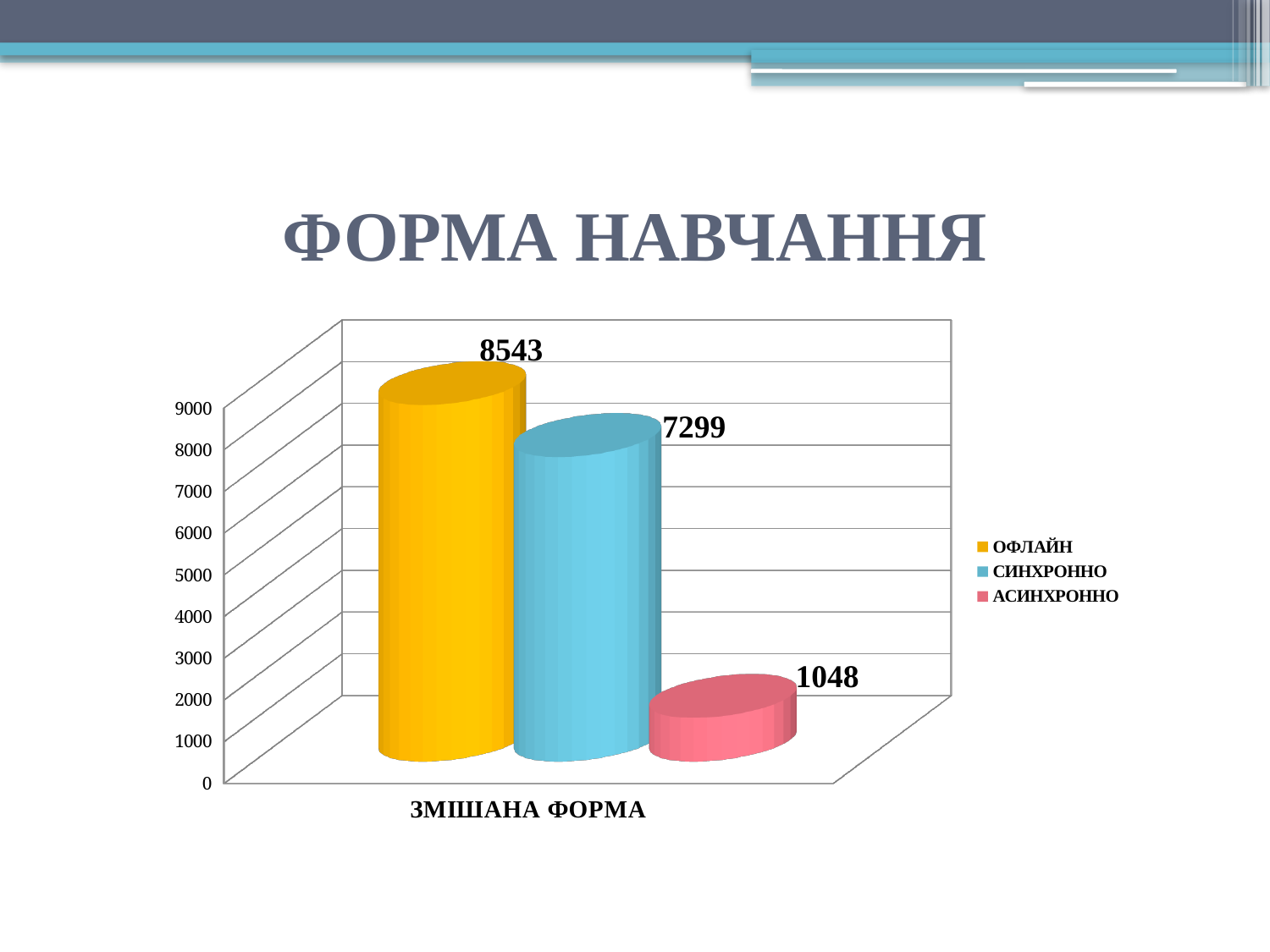
Which is larger, the value for СИНХРОННО or the value for АСИНХРОННО? СИНХРОННО What is the difference between the values for СИНХРОННО and АСИНХРОННО? 6251 What kind of chart is shown on the slide? bar chart What is the value for СИНХРОННО? 7299 How many series does the legend list? 3 What is the difference between the values for ОФЛАЙН and СИНХРОННО? 1244 What colour is the bar for АСИНХРОННО? pink Which series has the lowest value? АСИНХРОННО Which series has the highest value? ОФЛАЙН What is the value for ОФЛАЙН? 8543 What is the category label shown on the x axis? ЗМІШАНА ФОРМА What is the value for АСИНХРОННО? 1048